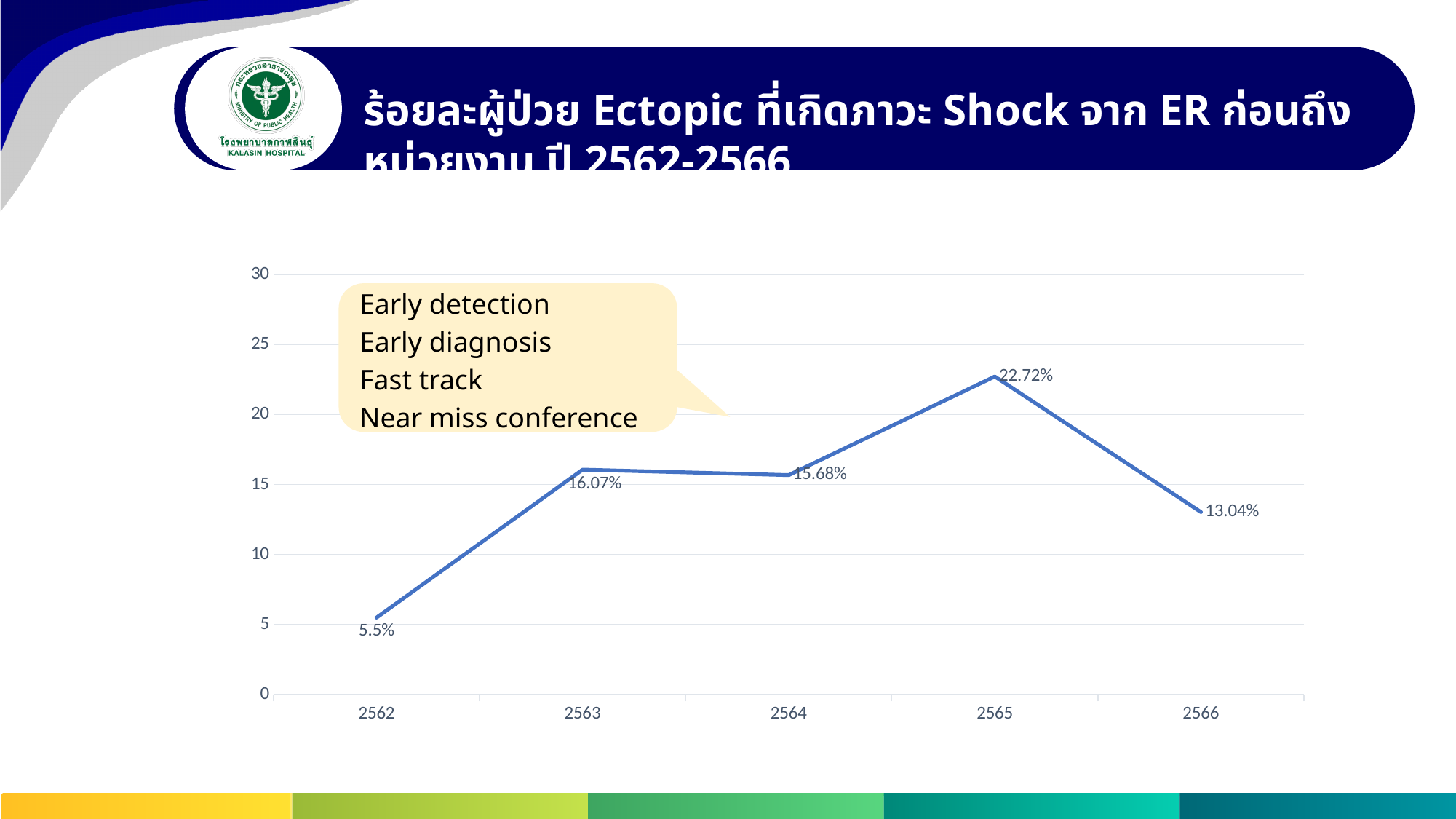
Is the value for 2565 greater or less than 20? greater Which year has the highest value? 2565 How many years are plotted on the x axis? 5 Does the value rise or fall from 2565 to 2566? fall What is the first item listed in the callout box on the chart? Early detection What kind of chart is shown on the slide? line chart What is the value for 2562? 5.5% Which year has the lowest value? 2562 What is the difference between the values for 2565 and 2566? 9.68% What is the value for 2566? 13.04% Which is larger, the value for 2563 or the value for 2564? 2563 What is the value for 2565? 22.72%